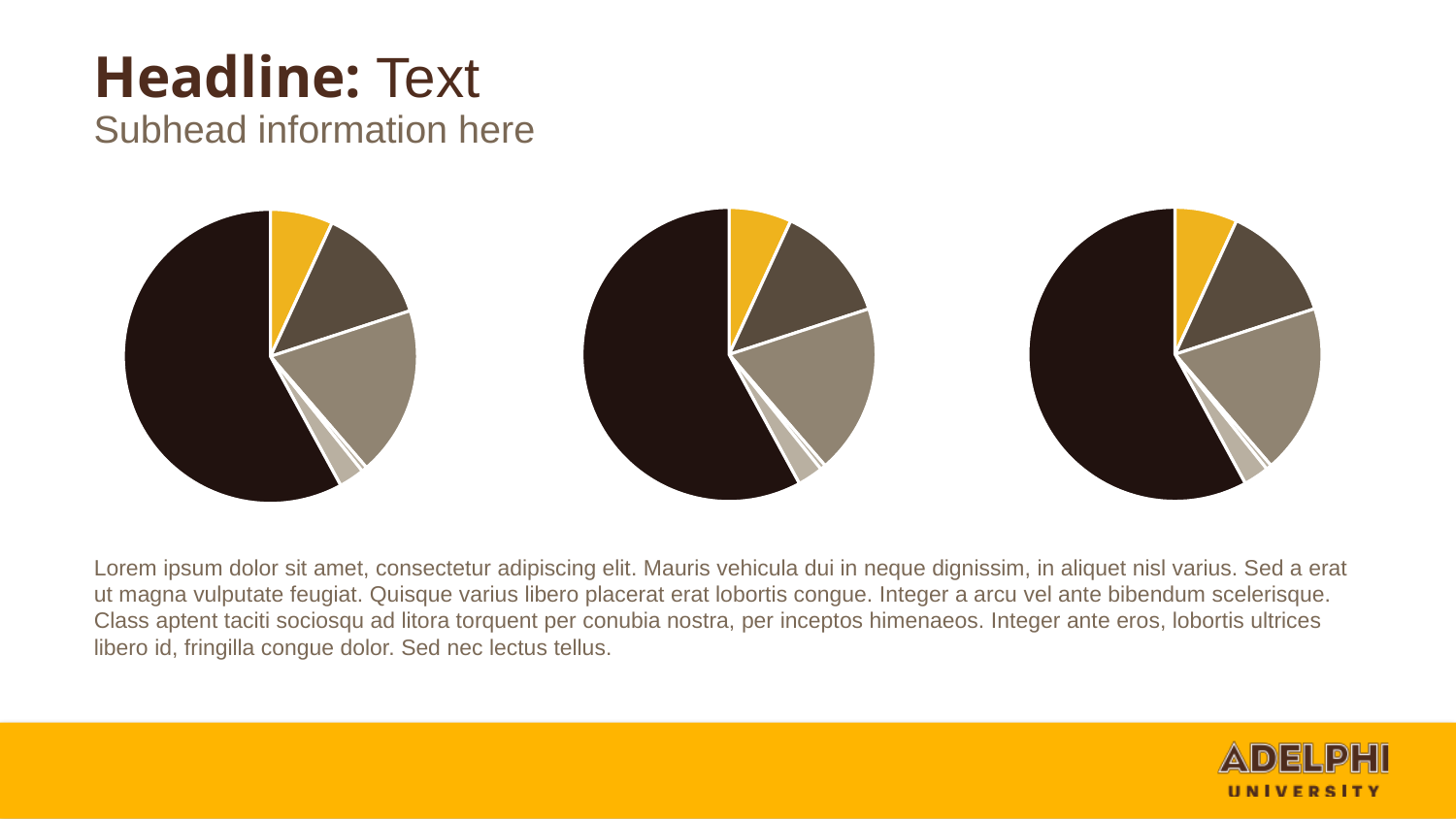
In the left pie chart, which is larger, the yellow slice or the grey-tan slice? grey-tan slice In the middle pie chart, how many slices are there? 6 In the left pie chart, how many slices are there? 6 In the right pie chart, which is larger, the yellow slice or the medium brown slice? medium brown slice Does the middle pie chart show data labels on its slices? No Does the left pie chart have a legend? No What kind of chart is the left chart on the slide? pie chart In the right pie chart, how many slices are there? 6 In the middle pie chart, which colour slice is the largest? dark brown In the left pie chart, which colour slice is the largest? dark brown